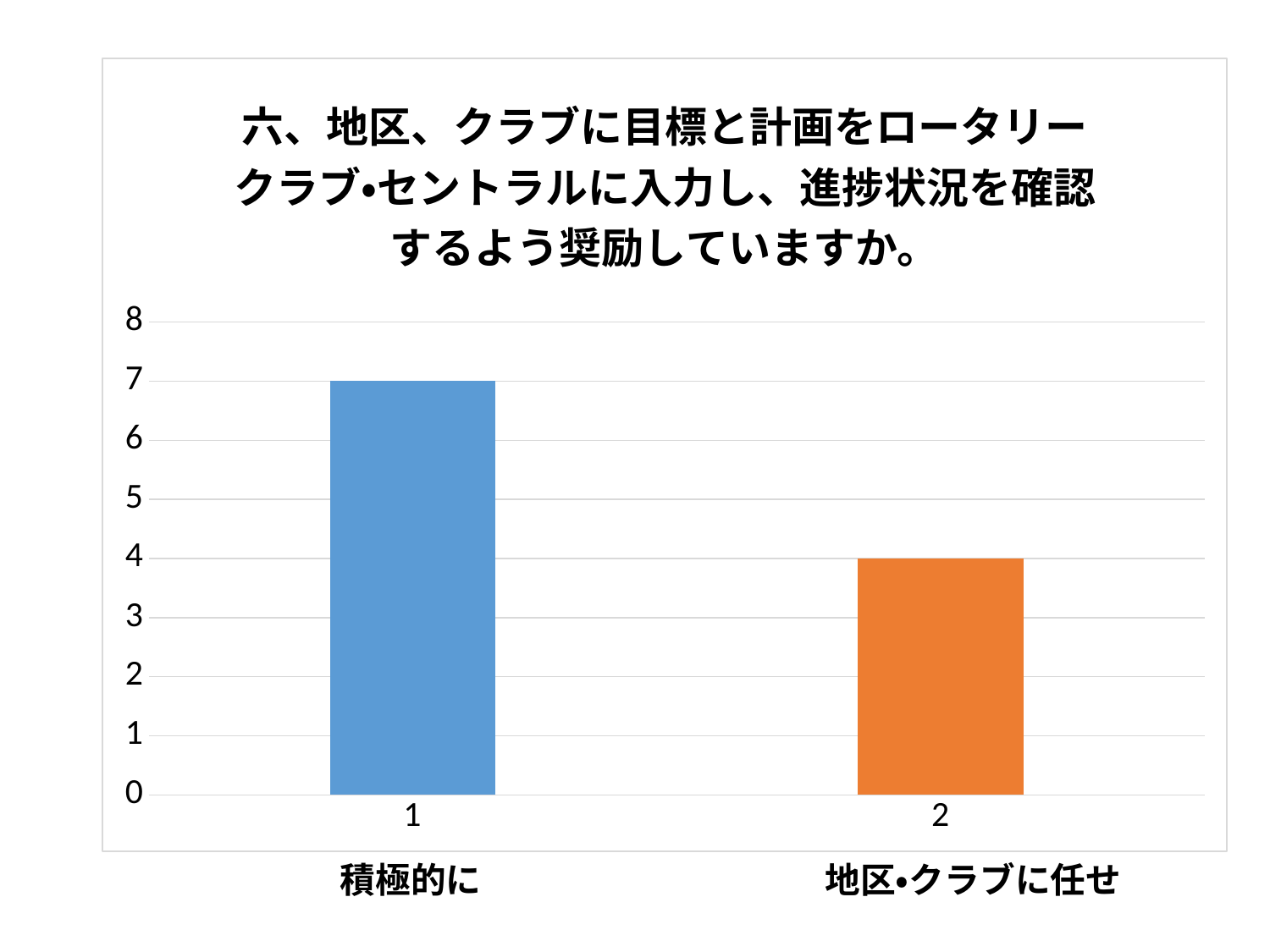
What kind of chart is shown on the slide? bar chart Which category has the highest value? 1 (積極的に) What is the maximum value shown on the vertical axis? 8 What is the value for category 1 (積極的に)? 7 Is the value for category 2 greater or less than 5? less Which category has the lowest value? 2 (地区•クラブに任せ) What colour is the bar for category 2? orange Is the value for category 1 greater or less than 5? greater What is the difference between the values for category 1 and category 2? 3 How many categories are shown in the chart? 2 Which is larger, the value for 積極的に or the value for 地区•クラブに任せ? 積極的に What is the value for category 2 (地区•クラブに任せ)? 4